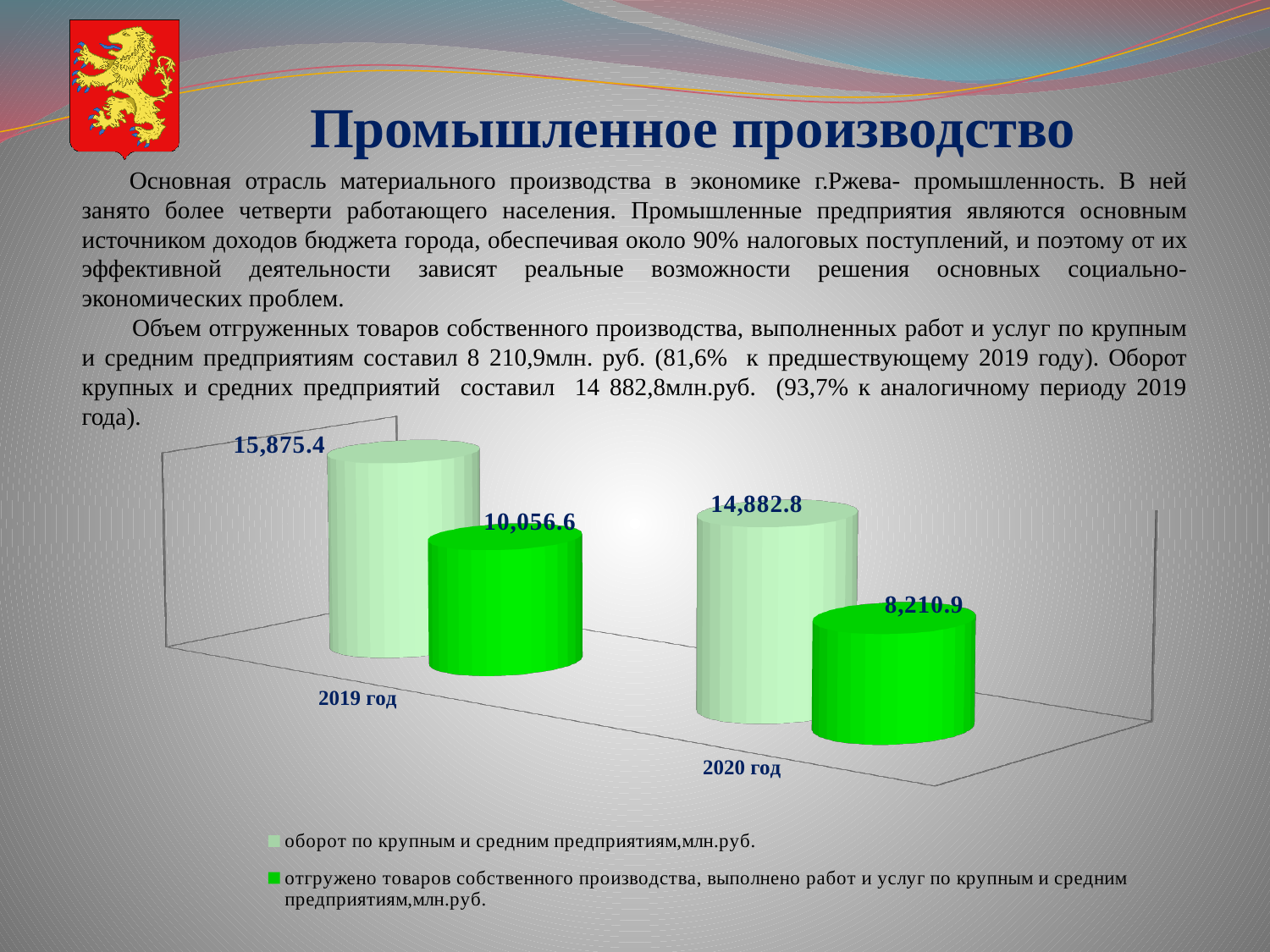
How many years (categories) are shown in the chart? 2 What is the value of оборот по крупным и средним предприятиям for 2020 год? 14,882.8 What is the difference between the two series values for 2020 год? 6,671.9 What is the value of отгружено товаров собственного производства for 2020 год? 8,210.9 How many series does the legend list? 2 What is the value of оборот по крупным и средним предприятиям for 2019 год? 15,875.4 What is the value of отгружено товаров собственного производства for 2019 год? 10,056.6 Which year has the higher value for оборот по крупным и средним предприятиям? 2019 год Is the value of отгружено товаров собственного производства larger in 2019 год or 2020 год? 2019 год Do the values of both series rise or fall from 2019 год to 2020 год? fall Which bar in the chart has the lowest value? отгружено товаров собственного производства, 2020 год By how much did оборот по крупным и средним предприятиям decrease from 2019 год to 2020 год? 992.6